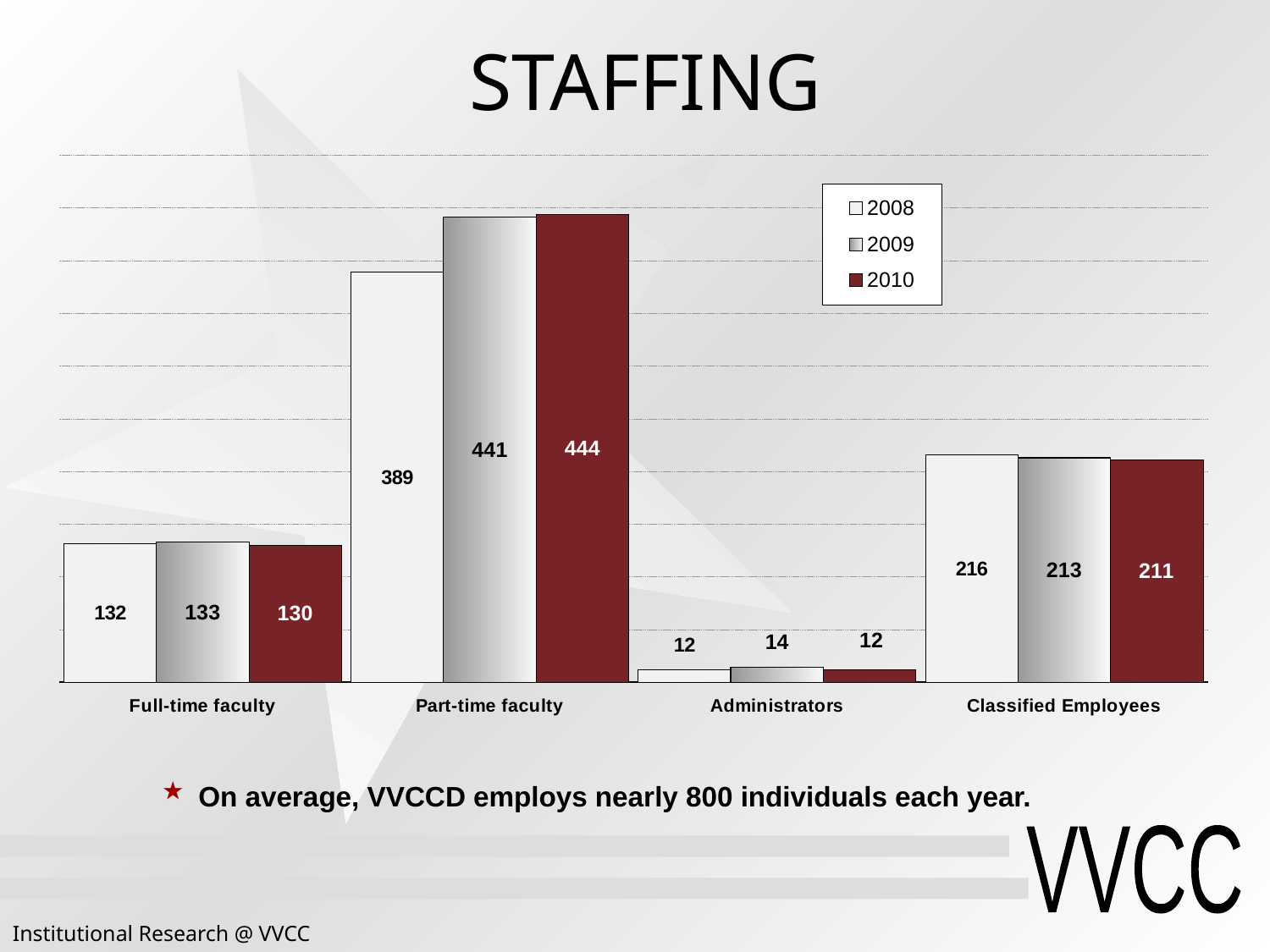
What was the number of part-time faculty in 2010? 444 How many series does the legend list? 3 Which category had the lowest value in 2008? Administrators How many administrators were there in 2009? 14 Did the number of part-time faculty rise or fall from 2008 to 2010? Rise What kind of chart is shown on the slide? Bar chart Which category had the highest value in 2009? Part-time faculty Which is larger: full-time faculty in 2009 or full-time faculty in 2010? Full-time faculty in 2009 How many categories are shown on the x axis? 4 What is the difference between classified employees in 2008 and in 2010? 5 What is the difference between part-time faculty in 2010 and in 2008? 55 What was the number of classified employees in 2008? 216